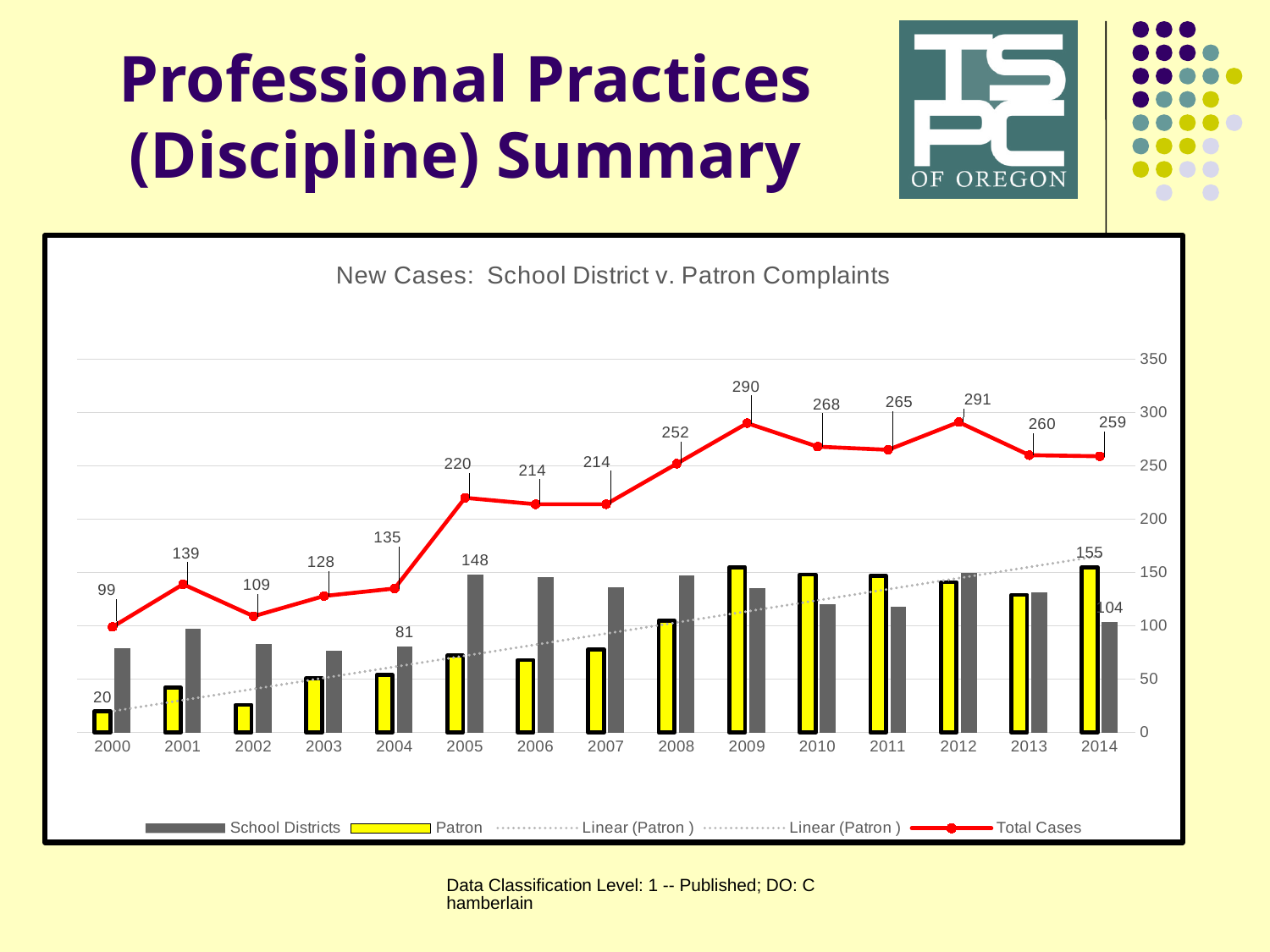
Is the Patron value for 2002 greater or less than 50? less Which year has the larger Total Cases value, 2010 or 2011? 2010 What is the Patron value for 2014? 155 In which year is the Total Cases value lowest? 2000 What is the title of the chart? New Cases: School District v. Patron Complaints In which year is the Total Cases value highest? 2012 What is the difference between the Total Cases values for 2012 and 2013? 31 How many series does the legend list? 5 What is the Total Cases value for 2005? 220 How many years are shown on the x axis? 15 What is the Patron value for 2000? 20 What is the Total Cases value for 2009? 290